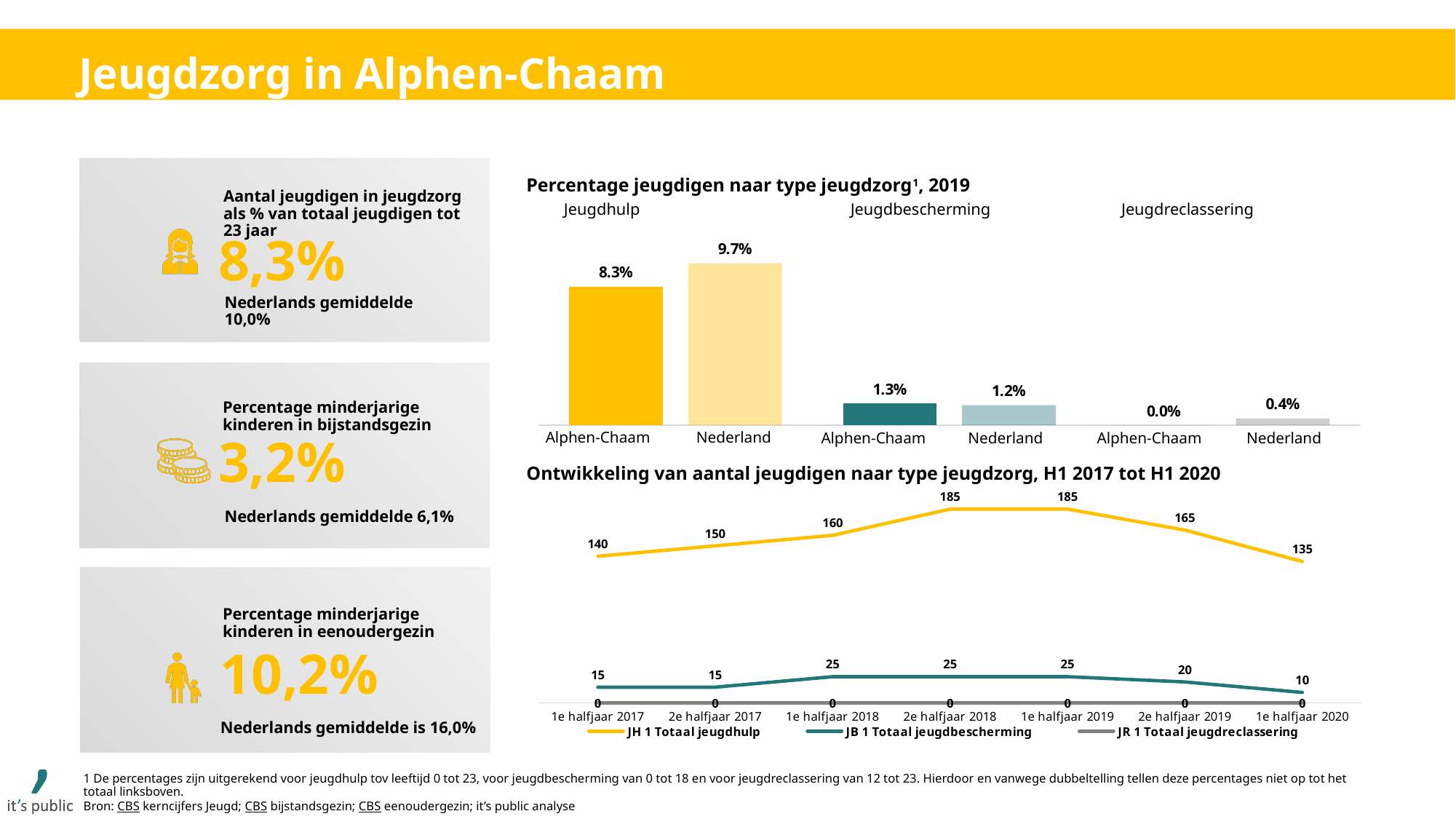
In the chart 'Percentage jeugdigen naar type jeugdzorg, 2019', what is the Jeugdbescherming value for Nederland? 1.2% In the chart 'Ontwikkeling van aantal jeugdigen naar type jeugdzorg, H1 2017 tot H1 2020', how many time points are shown on the x axis? 7 In the chart 'Ontwikkeling van aantal jeugdigen naar type jeugdzorg, H1 2017 tot H1 2020', what is the difference between the highest and lowest values of JH 1 Totaal jeugdhulp? 50 In the chart 'Percentage jeugdigen naar type jeugdzorg, 2019', what is the Jeugdhulp value for Alphen-Chaam? 8.3% What kind of chart is 'Percentage jeugdigen naar type jeugdzorg, 2019'? Bar chart In the chart 'Ontwikkeling van aantal jeugdigen naar type jeugdzorg, H1 2017 tot H1 2020', what is the value of JB 1 Totaal jeugdbescherming in 2e halfjaar 2018? 25 In the chart 'Ontwikkeling van aantal jeugdigen naar type jeugdzorg, H1 2017 tot H1 2020', what is the value of JH 1 Totaal jeugdhulp in 1e halfjaar 2020? 135 In the chart 'Percentage jeugdigen naar type jeugdzorg, 2019', which is larger for Jeugdbescherming: Alphen-Chaam or Nederland? Alphen-Chaam In the chart 'Ontwikkeling van aantal jeugdigen naar type jeugdzorg, H1 2017 tot H1 2020', how many series does the legend list? 3 In the chart 'Percentage jeugdigen naar type jeugdzorg, 2019', what is the difference between the Jeugdhulp values for Nederland and Alphen-Chaam? 1.4% In the chart 'Percentage jeugdigen naar type jeugdzorg, 2019', which bar is the highest? Nederland (Jeugdhulp), 9.7% In the chart 'Percentage jeugdigen naar type jeugdzorg, 2019', what is the Jeugdreclassering value for Alphen-Chaam? 0.0%